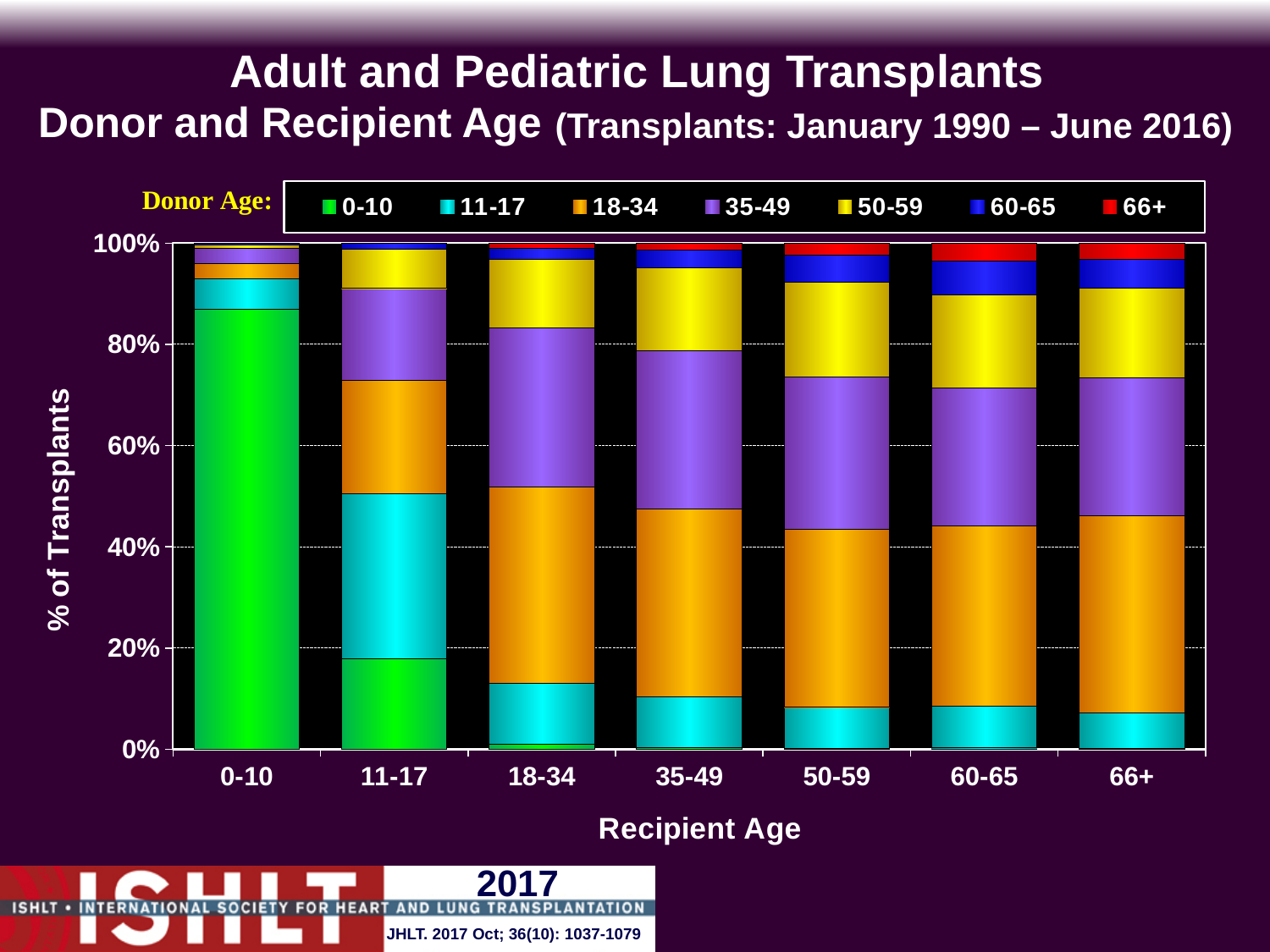
What kind of chart is shown on the slide? Stacked bar chart Is the share of donors aged 50-59 larger for recipients aged 50-59 or for recipients aged 0-10? 50-59 Which recipient age group has the largest share of donors aged 11-17? 11-17 Is the share of donors aged 18-34 larger for recipients aged 18-34 or for recipients aged 11-17? 18-34 How many donor age groups does the legend list? 7 Is the share of donors aged 18-34 for recipients aged 18-34 greater or less than 20%? greater How many recipient age categories are shown on the x axis? 7 Which recipient age group has the largest share of donors aged 0-10? 0-10 Is the share of donors aged 11-17 for recipients aged 11-17 greater or less than 20%? greater What is the title of the y axis? % of Transplants What is the title of the x axis? Recipient Age Is the share of donors aged 0-10 for recipients aged 0-10 greater or less than 80%? greater